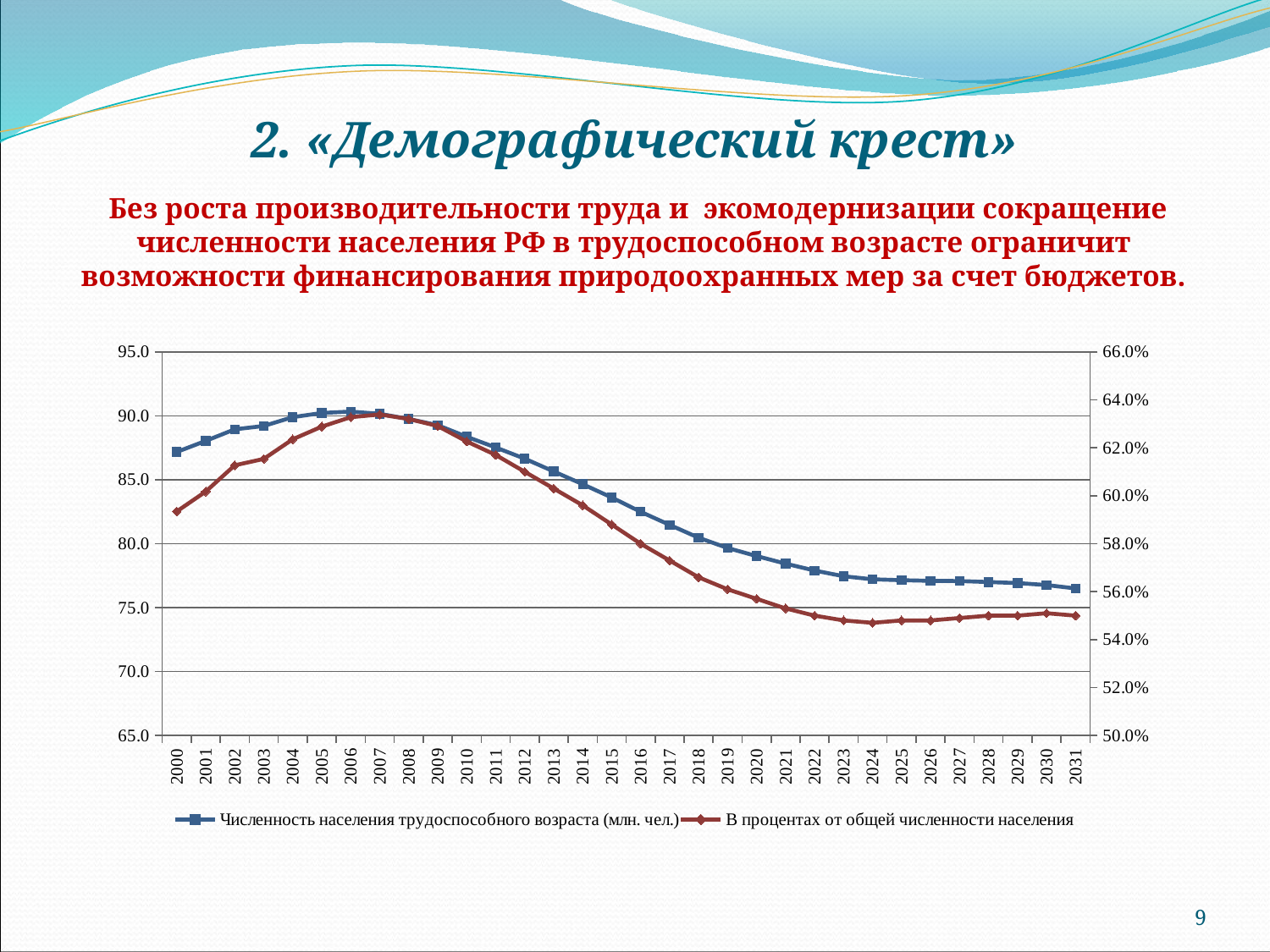
Is the value of 'В процентах от общей численности населения' in 2000 greater or less than 60.0%? less What is the last year shown on the x axis of the chart? 2031 Is the value of 'Численность населения трудоспособного возраста (млн. чел.)' in 2031 greater or less than 75.0? greater How many series does the chart legend list? 2 How many years are plotted along the x axis of the chart? 32 Does the 'Численность населения трудоспособного возраста (млн. чел.)' series rise or fall between 2010 and 2031? fall What is the first year shown on the x axis of the chart? 2000 Is the value of 'В процентах от общей численности населения' in 2005 greater or less than 62.0%? greater Which year has the lowest value for 'Численность населения трудоспособного возраста (млн. чел.)'? 2031 What kind of chart is shown on the slide? line chart